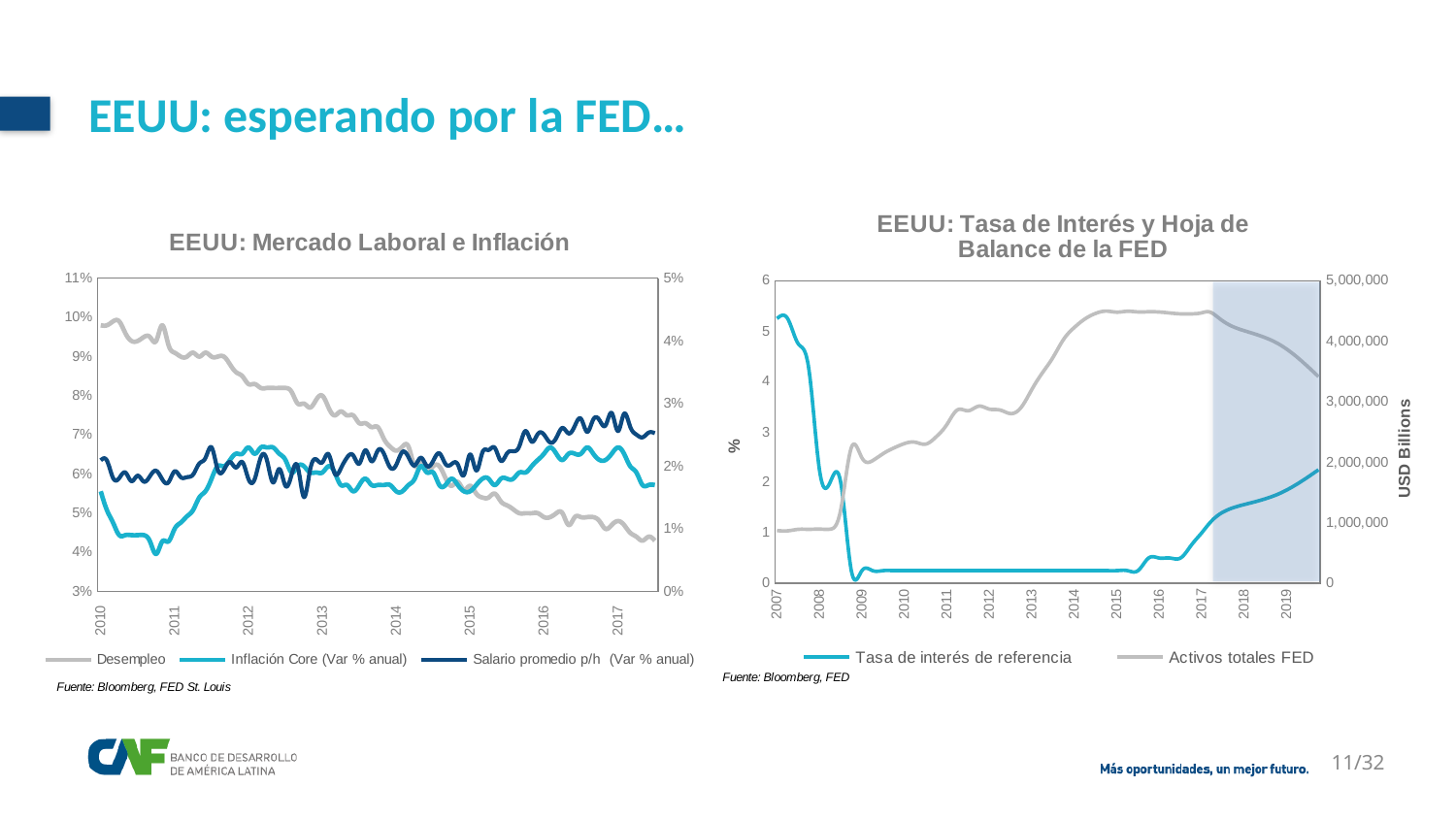
In the left chart 'EEUU: Mercado Laboral e Inflación', is the Desempleo value at the start of 2010 greater or less than 9%? greater In the right chart 'EEUU: Tasa de Interés y Hoja de Balance de la FED', what is the label of the right-hand vertical axis? USD Billions In the left chart 'EEUU: Mercado Laboral e Inflación', does the Desempleo series rise or fall from 2010 to 2017? Fall What kind of chart is the left chart titled 'EEUU: Mercado Laboral e Inflación'? Line chart In the right chart 'EEUU: Tasa de Interés y Hoja de Balance de la FED', is the Tasa de interés de referencia during 2012 greater or less than 1? less In the right chart 'EEUU: Tasa de Interés y Hoja de Balance de la FED', is the Tasa de interés de referencia at the start of 2007 greater or less than 5? greater How many series does the legend of the left chart 'EEUU: Mercado Laboral e Inflación' list? 3 In the right chart 'EEUU: Tasa de Interés y Hoja de Balance de la FED', does the Activos totales FED series rise or fall between 2009 and 2015? Rise How many series does the legend of the right chart 'EEUU: Tasa de Interés y Hoja de Balance de la FED' list? 2 What kind of chart is the right chart titled 'EEUU: Tasa de Interés y Hoja de Balance de la FED'? Line chart